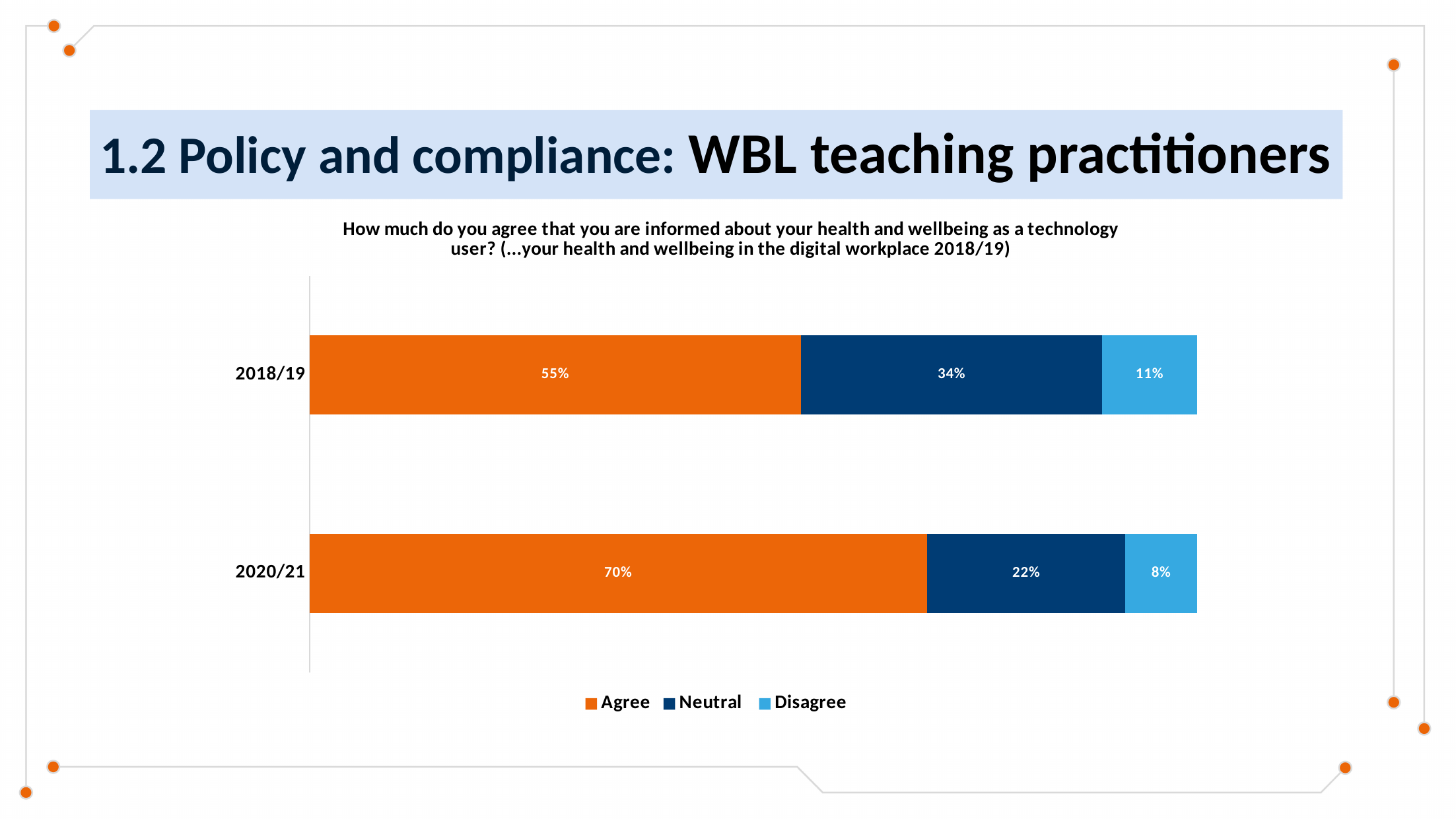
What percentage of respondents were neutral in 2020/21? 22% What percentage of respondents disagreed in 2018/19? 11% What percentage of respondents agreed in 2020/21? 70% Which year has the lower Disagree percentage? 2020/21 How many years (categories) are shown in the chart? 2 Which colour represents the Disagree series in the chart? Light blue Which year has the higher Agree percentage? 2020/21 How many series does the legend list? 3 By how many percentage points did the Agree share increase from 2018/19 to 2020/21? 15 Is the Neutral percentage larger in 2018/19 or 2020/21? 2018/19 What percentage of respondents agreed in 2018/19? 55% What kind of chart is shown on the slide? Stacked bar chart